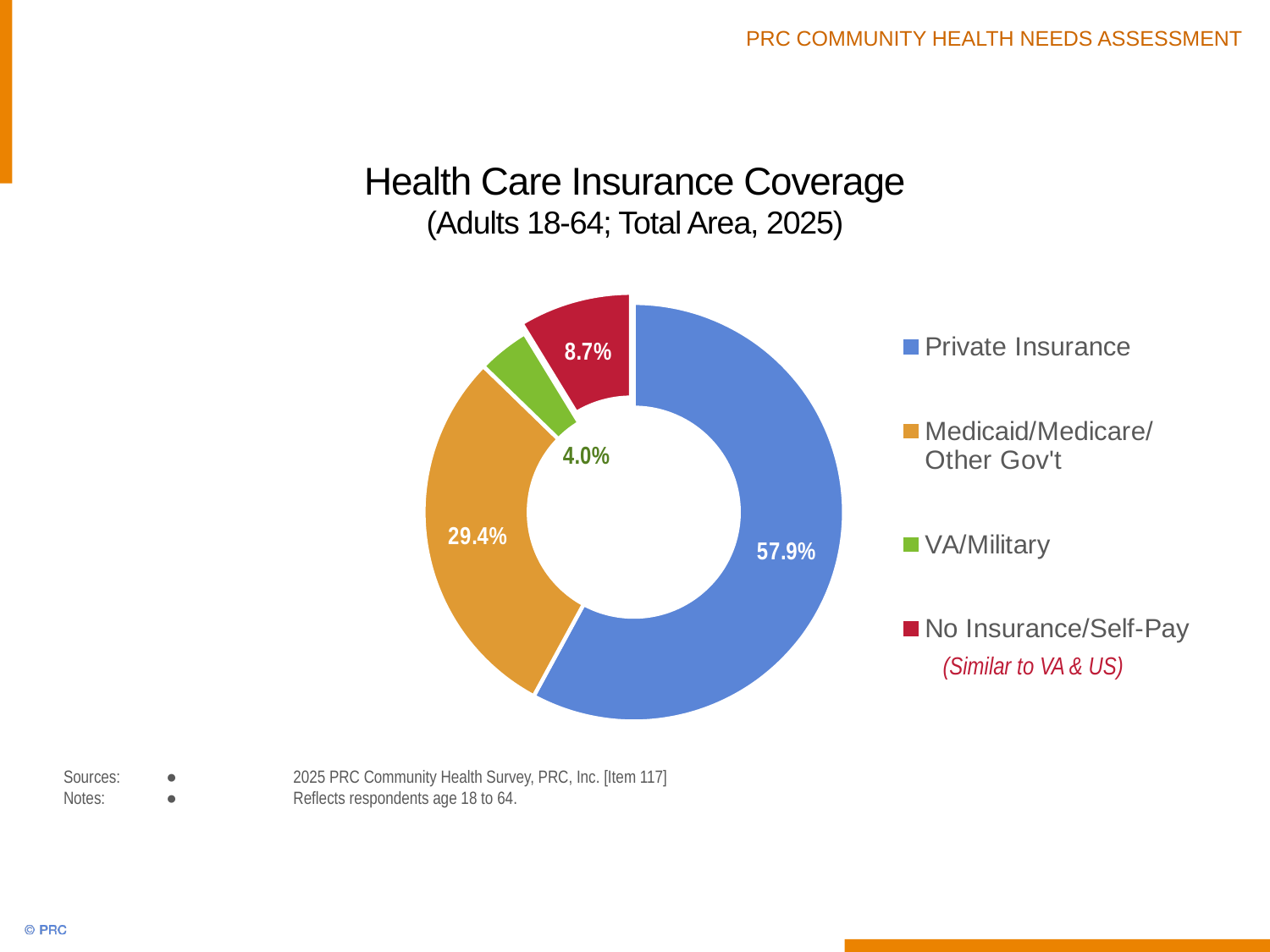
What share of adults 18-64 have Private Insurance? 57.9% What is the title of the chart? Health Care Insurance Coverage (Adults 18-64; Total Area, 2025) Which insurance coverage category has the smallest share? VA/Military Which insurance coverage category has the largest share? Private Insurance What colour represents the No Insurance/Self-Pay category? Red What share of adults 18-64 have Medicaid/Medicare/Other Gov't coverage? 29.4% How many categories are shown in the chart? 4 What share of adults 18-64 have No Insurance/Self-Pay? 8.7% What kind of chart is shown on the slide? Pie chart (doughnut) What share of adults 18-64 have VA/Military coverage? 4.0% What is the difference in percentage points between Private Insurance and Medicaid/Medicare/Other Gov't? 28.5 Which is larger: the share for No Insurance/Self-Pay or the share for VA/Military? No Insurance/Self-Pay